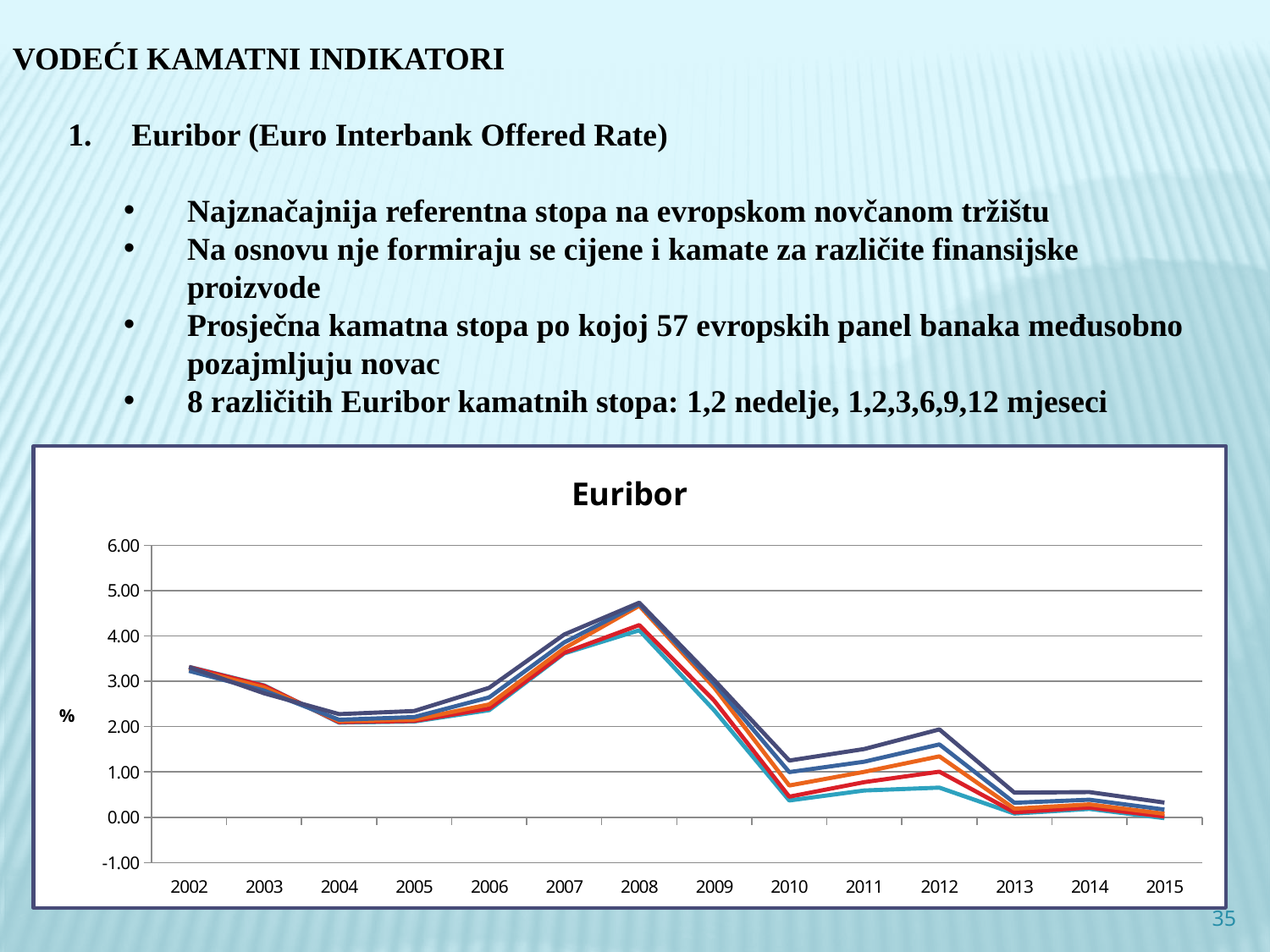
Do the values rise or fall between 2005 and 2008? rise In which year do the lines in the chart reach their lowest point? 2015 What kind of chart is shown on the slide? line chart Are the values for 2013 greater or less than 1.00? less What label is shown on the vertical axis of the chart? % How many years are shown along the x axis of the chart? 14 Are the values for 2015 greater or less than 1.00? less Do the values rise or fall between 2008 and 2010? fall Are the values for 2008 greater or less than 4.00? greater In which year do the lines in the chart reach their highest point? 2008 What is the title of the chart? Euribor